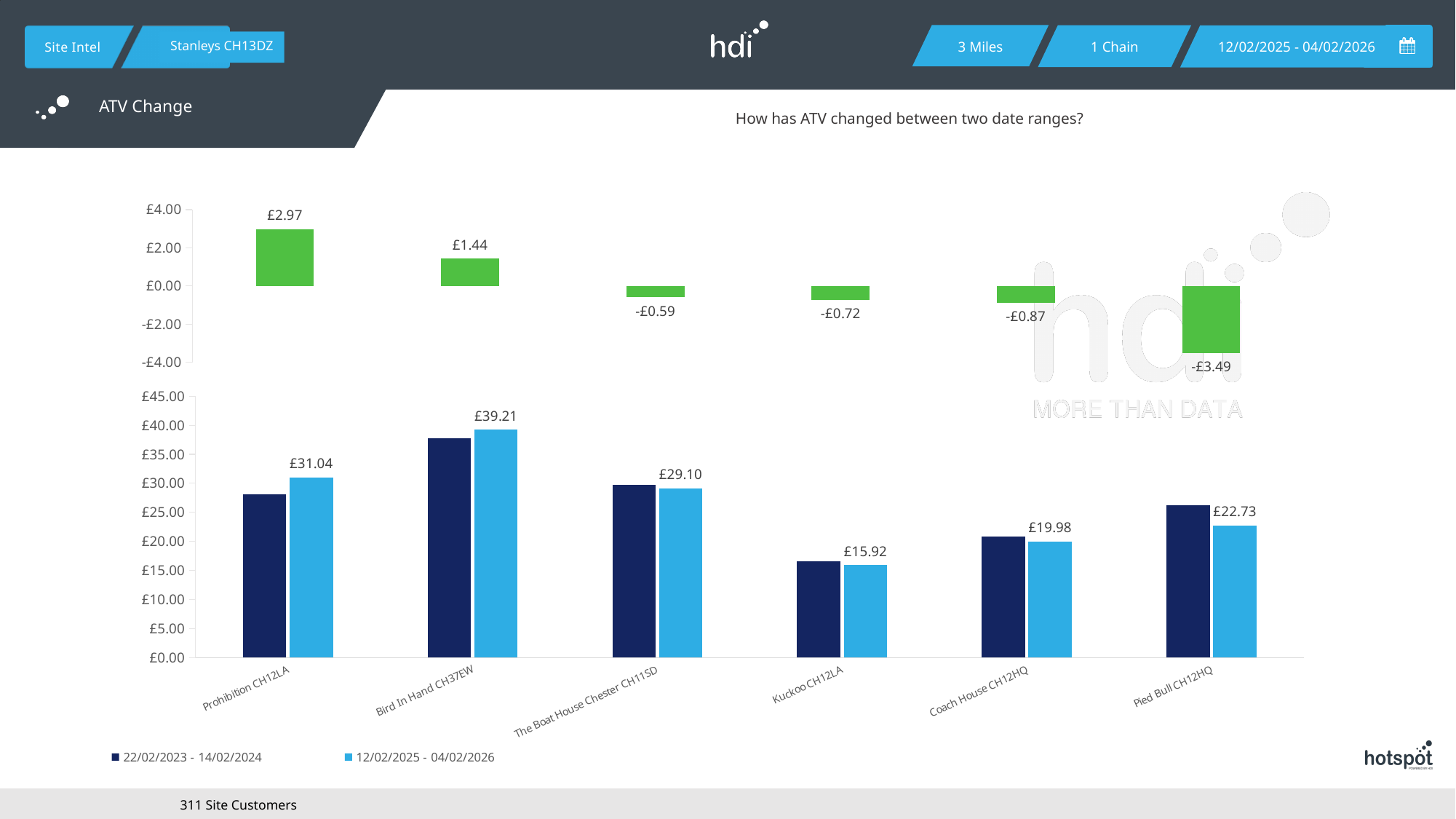
In the top chart, what is the ATV change for Pied Bull CH12HQ? -£3.49 In the top chart, what is the ATV change for Prohibition CH12LA? £2.97 In the top chart, which site has the lowest ATV change? Pied Bull CH12HQ How many series does the legend of the bottom chart list? 2 What kind of chart is the bottom chart? bar chart In the top chart, what is the difference between the ATV change for Prohibition CH12LA and Bird In Hand CH37EW? £1.53 In the bottom chart, what is the value for Bird In Hand CH37EW in the 12/02/2025 - 04/02/2026 series? £39.21 In the top chart, which site has the highest ATV change? Prohibition CH12LA In the bottom chart, is the value for Prohibition CH12LA in the 22/02/2023 - 14/02/2024 series greater or less than £25.00? greater How many sites are shown on the x axis of the bottom chart? 6 In the bottom chart, what is the value for Kuckoo CH12LA in the 12/02/2025 - 04/02/2026 series? £15.92 In the bottom chart, what is the difference between the 12/02/2025 - 04/02/2026 values for Bird In Hand CH37EW and Prohibition CH12LA? £8.17